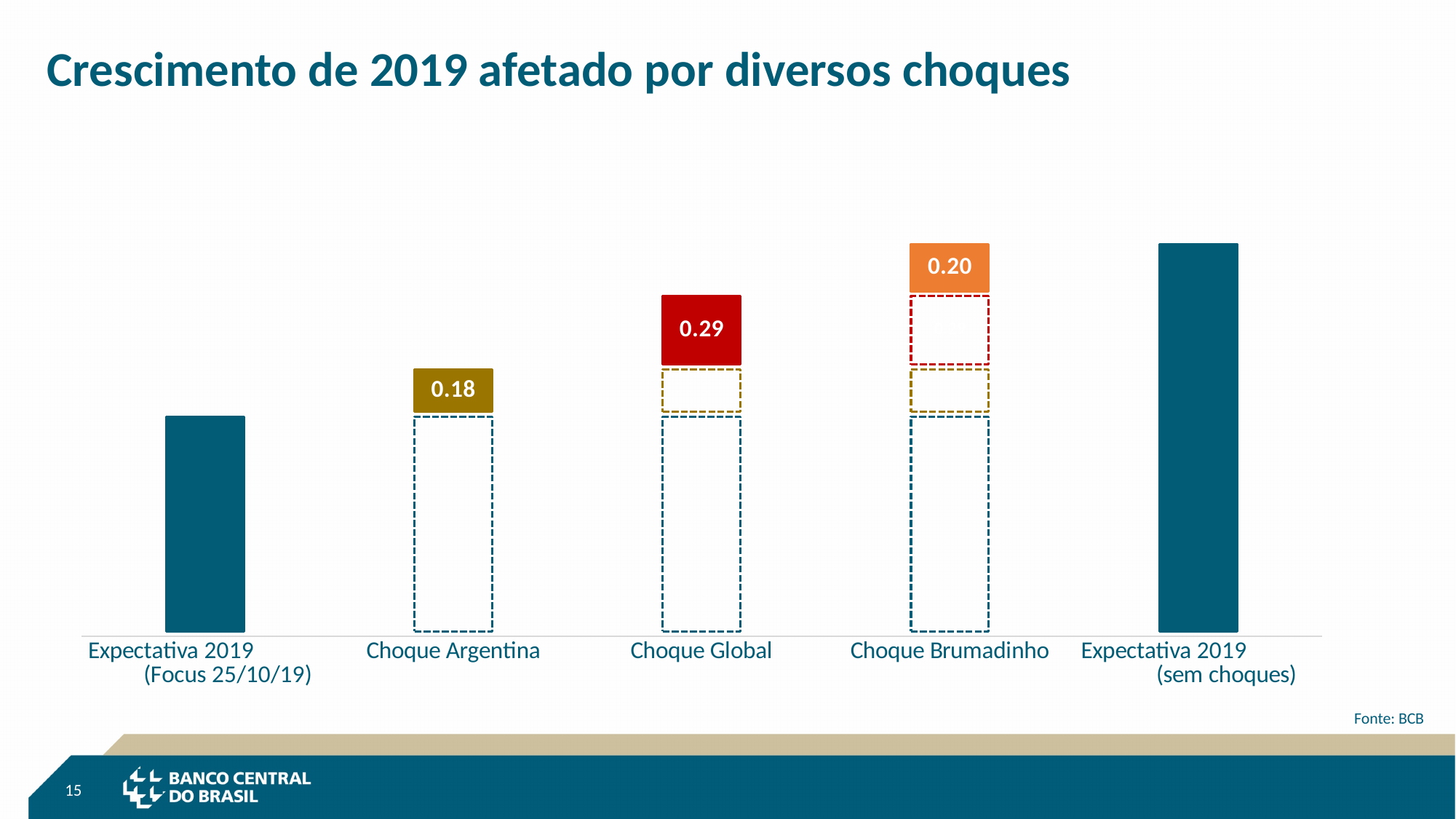
Which of the three shocks (choques) has the largest labelled value? Choque Global What is the title of the slide? Crescimento de 2019 afetado por diversos choques What is the difference between the values for Choque Global and Choque Brumadinho? 0.09 What is the difference between the values for Choque Global and Choque Argentina? 0.11 What value is shown for Choque Brumadinho? 0.20 What is the combined value of the three shocks (Choque Argentina, Choque Global and Choque Brumadinho)? 0.67 What kind of chart is shown on the slide? Bar chart How many categories are shown on the x axis of the chart? 5 What value is shown for Choque Argentina? 0.18 What value is shown for Choque Global? 0.29 Which is larger, the value for Choque Brumadinho or the value for Choque Argentina? Choque Brumadinho Which of the three shocks (choques) has the smallest labelled value? Choque Argentina